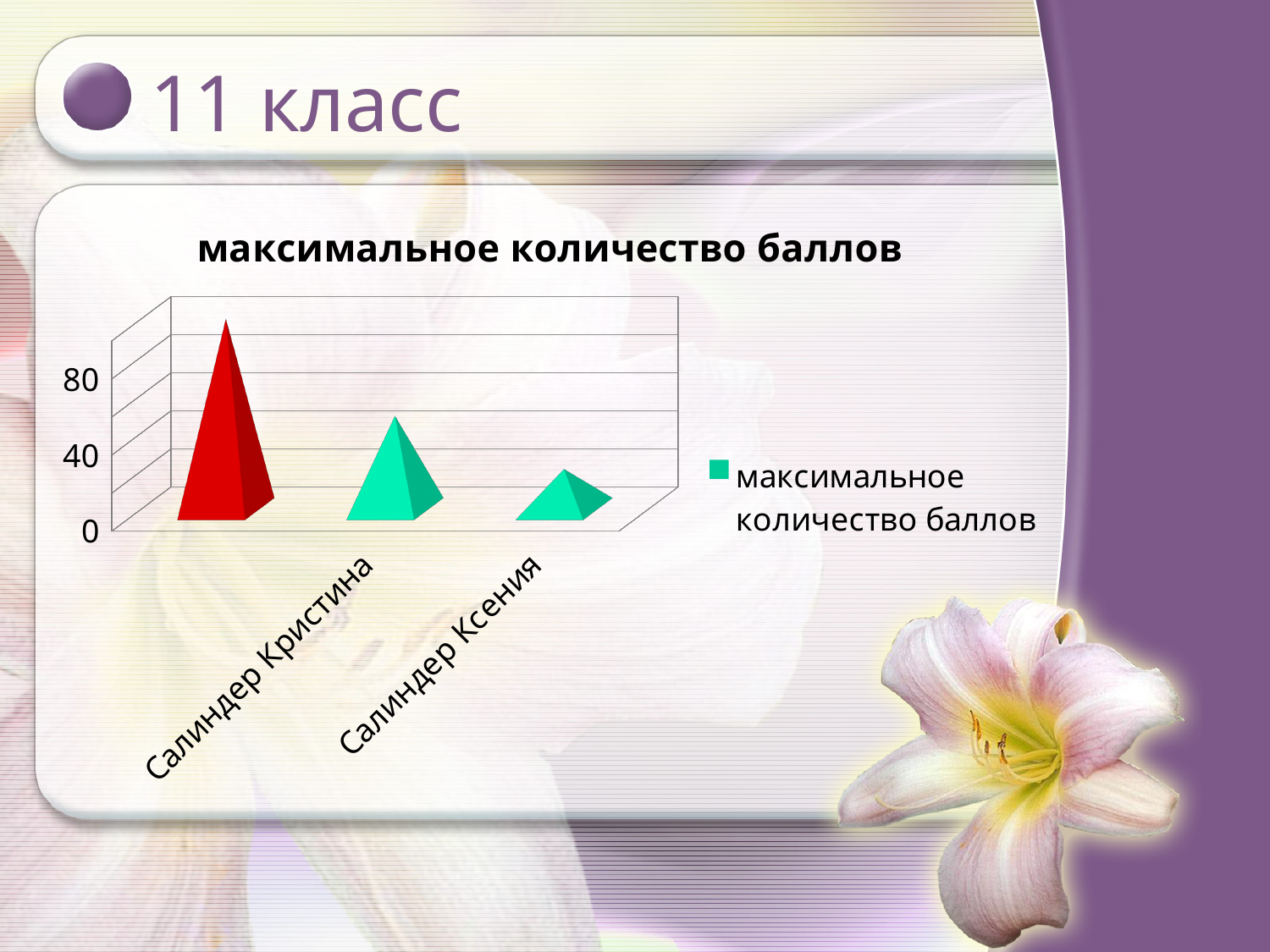
Is the value for Салиндер Кристина greater or less than 80? less What is the title of the chart? максимальное количество баллов Do the values rise or fall from left to right along the x axis? fall How many series does the legend list? 1 Which is larger, the value for Салиндер Кристина or the value for Салиндер Ксения? Салиндер Кристина What is the legend entry of the chart? максимальное количество баллов How many bars are plotted in the chart? 3 Is the value for Салиндер Ксения greater or less than 40? less Is the value for Салиндер Ксения greater or less than 80? less What kind of chart is shown on the slide? bar chart